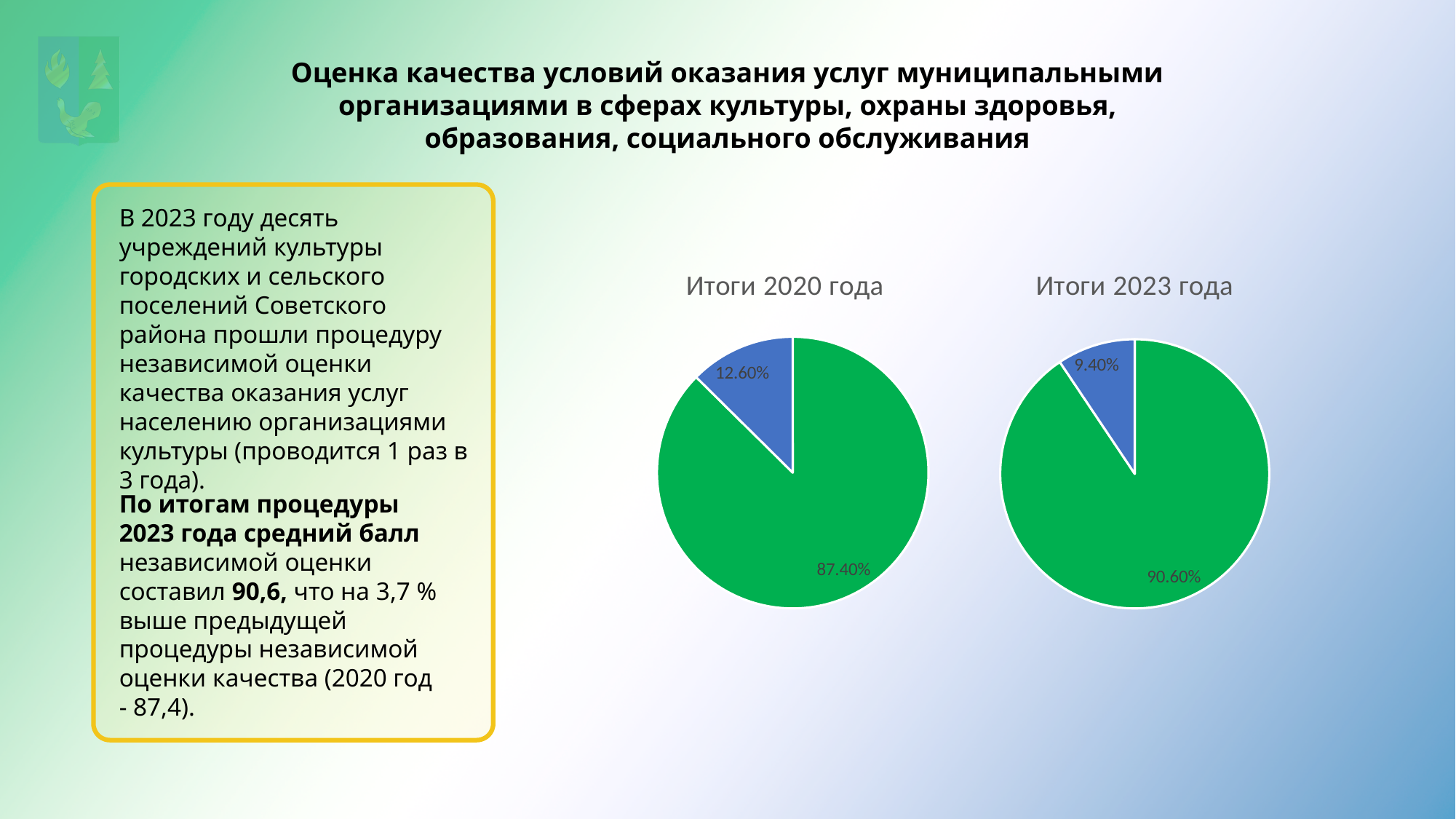
In the "Итоги 2023 года" chart, what value is shown on the green slice? 90.60% In the "Итоги 2023 года" chart, what value is shown on the blue slice? 9.40% In the "Итоги 2020 года" chart, which slice is the largest? the green slice (87.40%) In the "Итоги 2020 года" chart, what value is shown on the green slice? 87.40% In the "Итоги 2023 года" chart, which slice is the smallest? the blue slice (9.40%) In the "Итоги 2020 года" chart, what value is shown on the blue slice? 12.60% How many slices does the "Итоги 2023 года" pie chart have? 2 By how much does the blue slice in "Итоги 2020 года" exceed the blue slice in "Итоги 2023 года"? 3.20% What is the title of the pie chart on the right? Итоги 2023 года What kind of chart is "Итоги 2020 года"? pie chart What is the difference between the green and blue slices in the "Итоги 2020 года" chart? 74.80% Is the green slice larger in the "Итоги 2020 года" chart or in the "Итоги 2023 года" chart? Итоги 2023 года